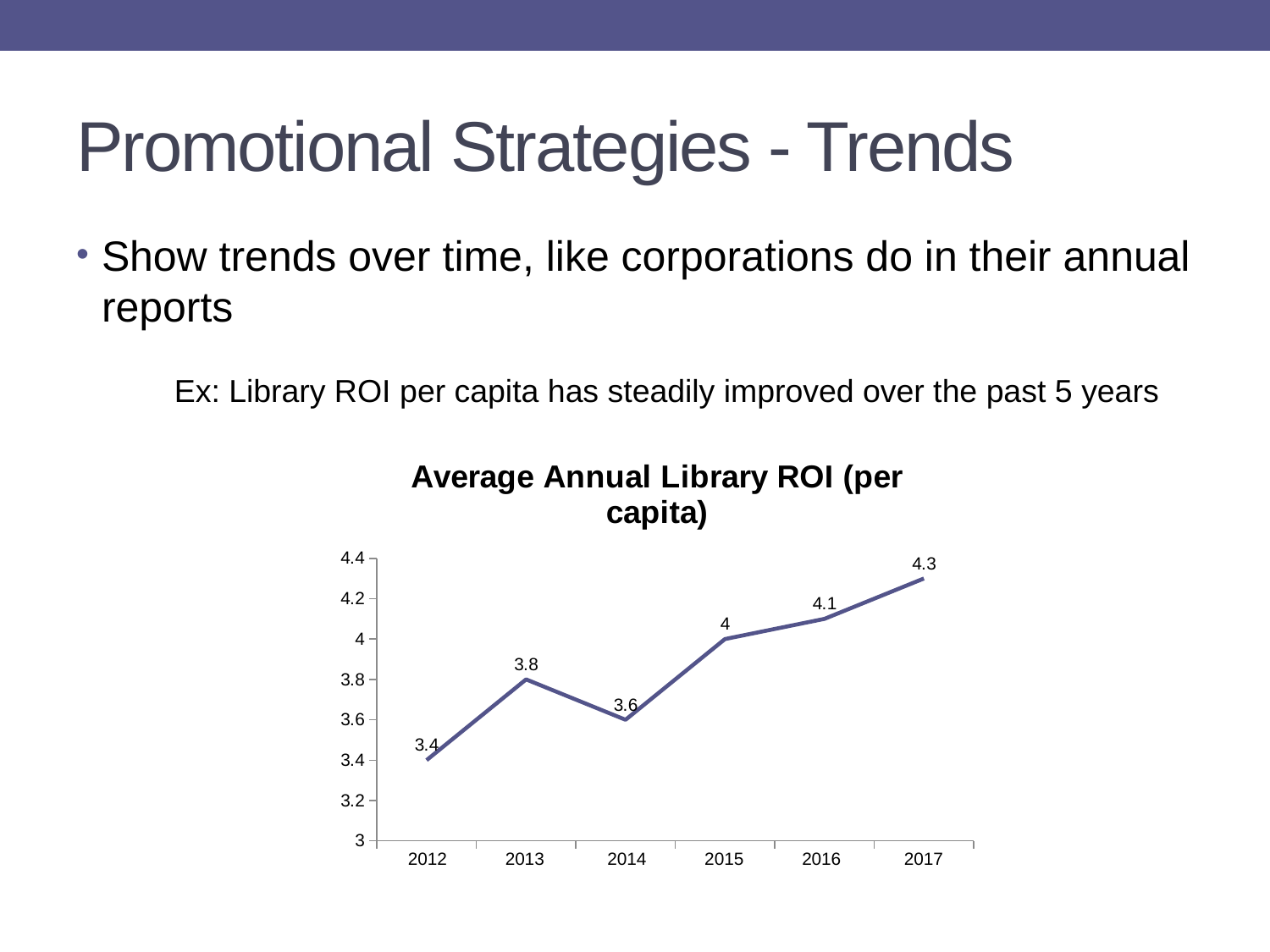
What kind of chart is shown? line chart Which year has the highest value? 2017 Do the values generally rise or fall from 2012 to 2017? rise Which year has the lowest value? 2012 Which is larger, the value for 2013 or the value for 2014? 2013 What is the value for 2012? 3.4 Is the value for 2015 greater or less than 3.8? greater What is the difference between the values for 2017 and 2012? 0.9 How many years are plotted on the chart? 6 What is the title of the chart? Average Annual Library ROI (per capita) What is the value for 2017? 4.3 What is the value for 2014? 3.6